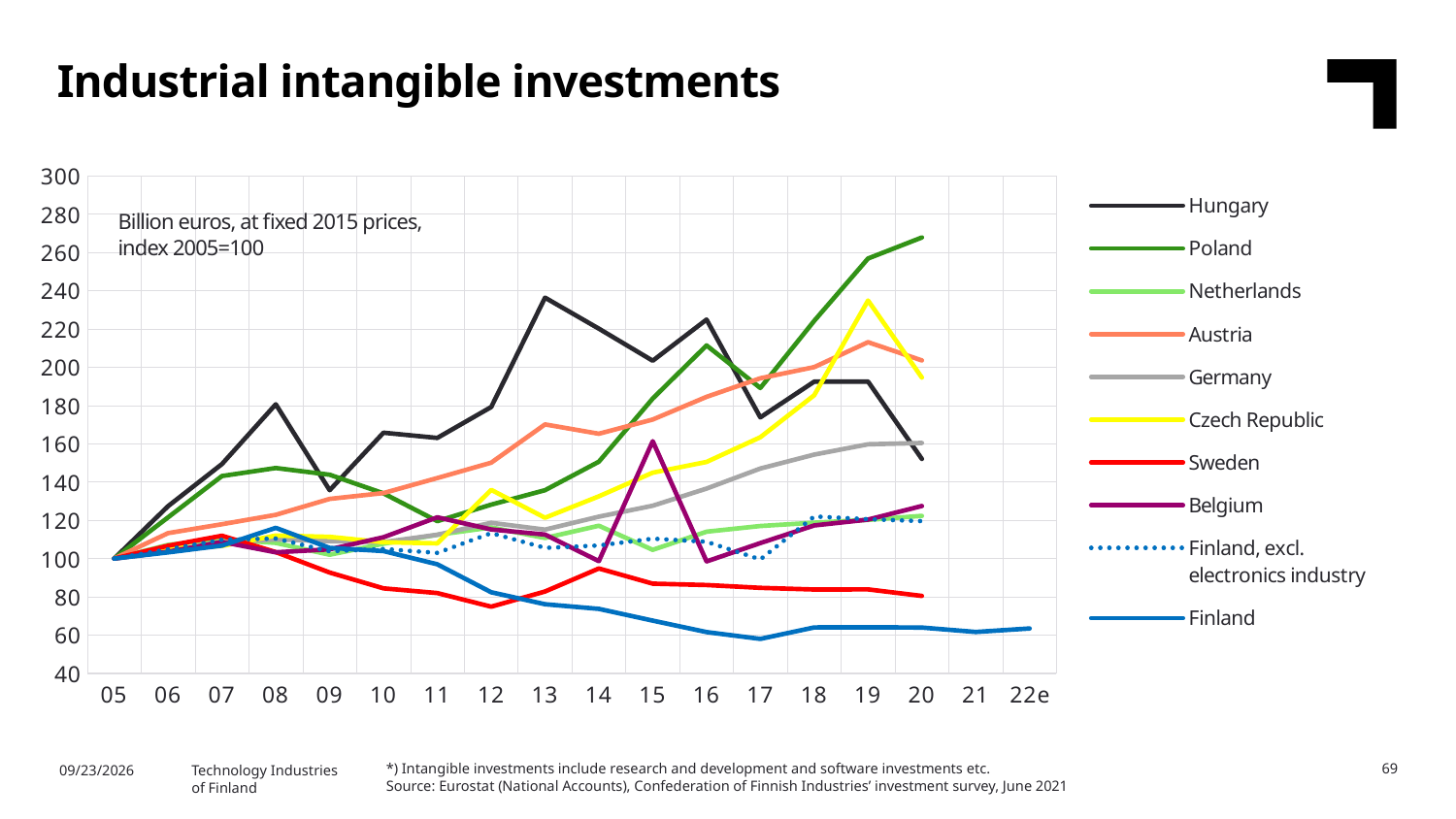
Is the value for Sweden in 2020 greater or less than 100? less How many series does the legend list? 10 What kind of chart is shown on the slide? line chart Does the Poland line rise or fall overall from 2005 to 2020? rise Is the value for Poland in 2020 greater or less than 240? greater Which series is drawn with a dotted line? Finland, excl. electronics industry In 2020, which is larger, the value for Austria or the value for Germany? Austria Does the Finland line rise or fall overall from 2005 to 2020? fall Which series has the lowest value in 2020? Finland Is the value for Hungary in 2013 greater or less than 220? greater Which country has the highest value in 2020? Poland